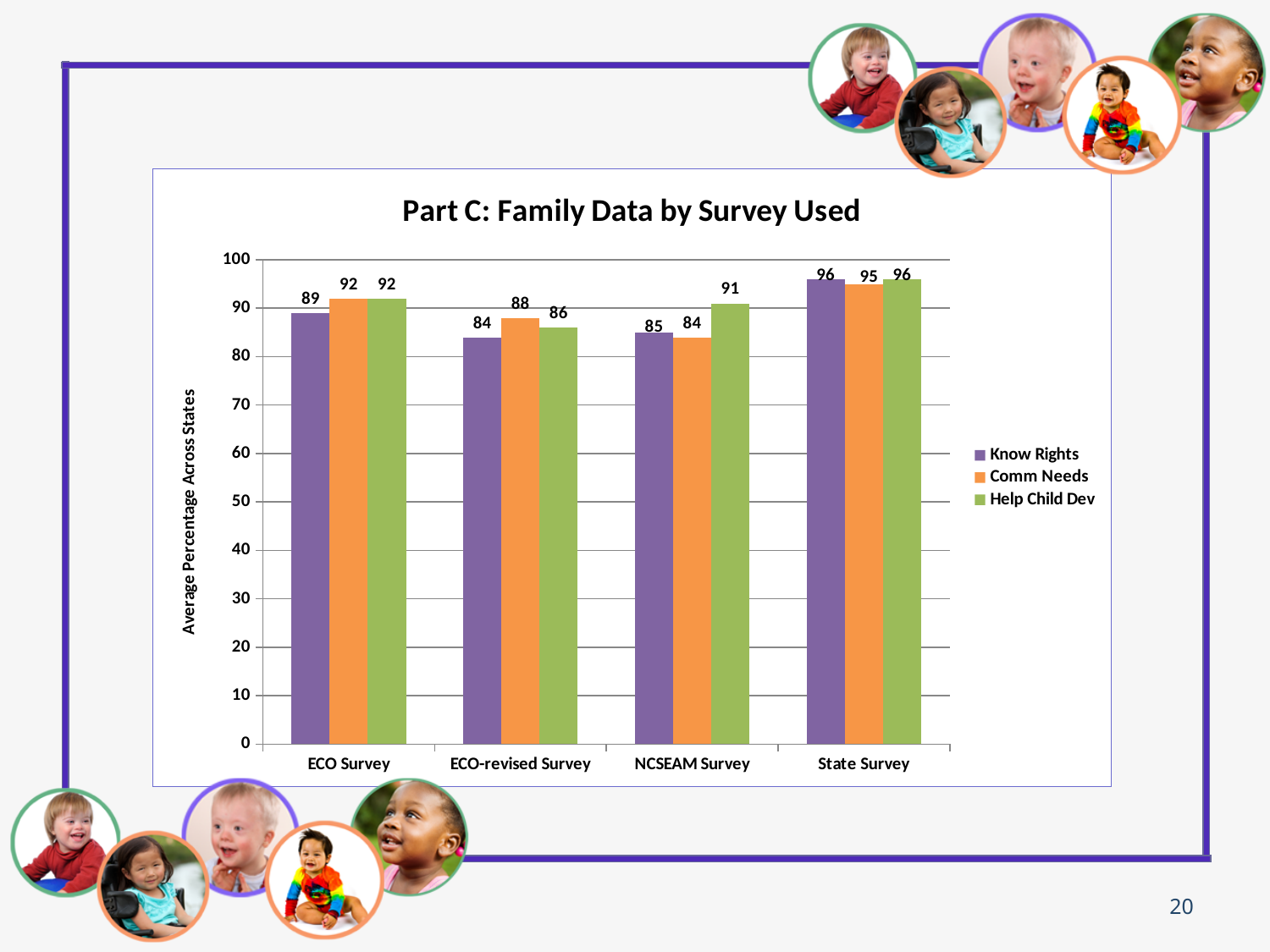
What kind of chart is shown on the slide? bar chart Which survey has the highest value for Know Rights? State Survey What is the value for Know Rights in the ECO Survey category? 89 What is the title of the chart? Part C: Family Data by Survey Used How many survey categories are shown on the x axis? 4 What is the value for Comm Needs in the ECO-revised Survey category? 88 What is the difference between the Help Child Dev values for the State Survey and the ECO-revised Survey? 10 What is the value for Help Child Dev in the NCSEAM Survey category? 91 Is the value for Know Rights in the ECO-revised Survey greater or less than 90? less Which is larger in the NCSEAM Survey category: Know Rights or Help Child Dev? Help Child Dev How many series does the legend list? 3 Which survey has the lowest value for Comm Needs? NCSEAM Survey